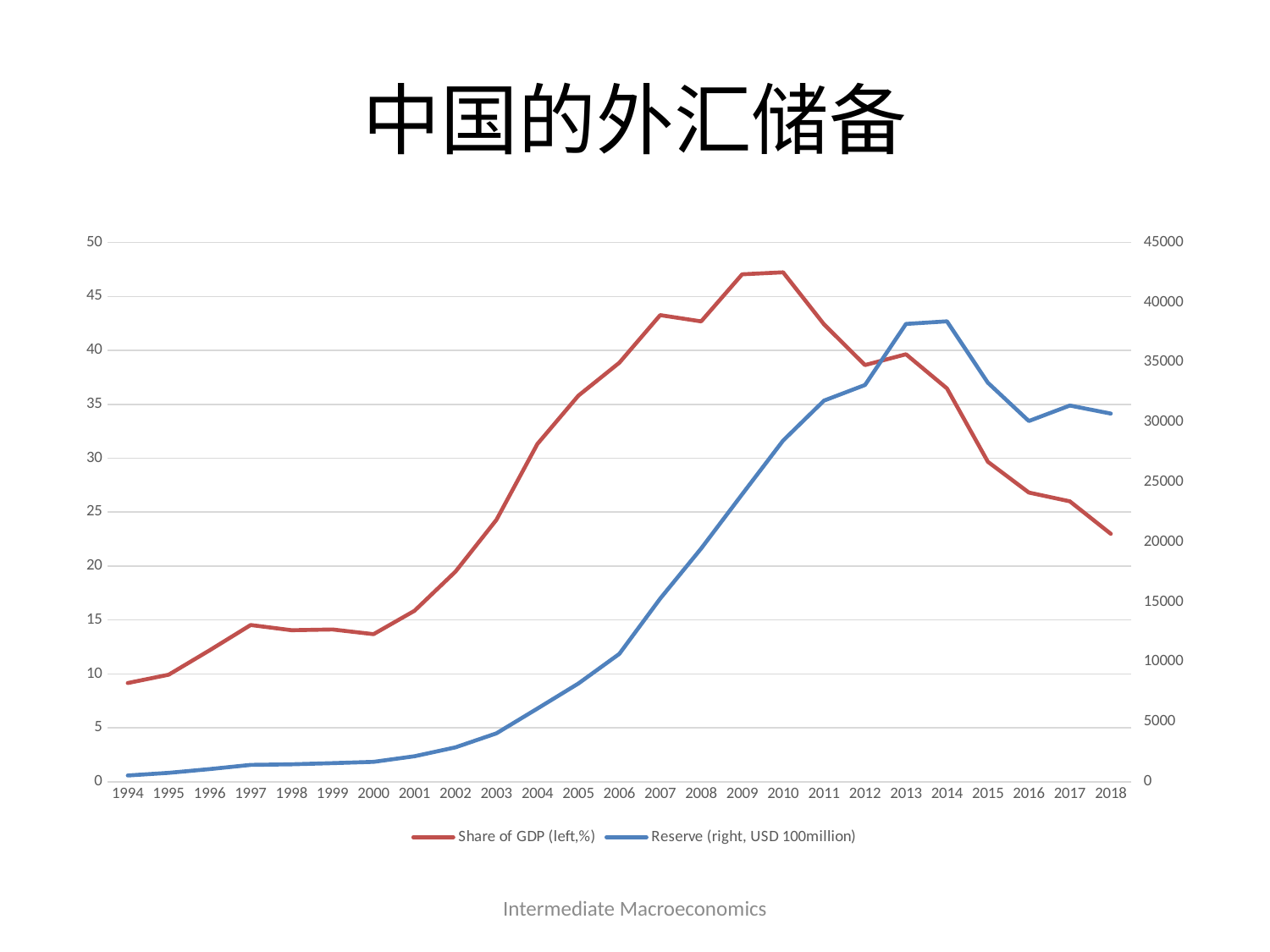
Which year has the lowest value for Share of GDP (left,%)? 1994 Is the Reserve (right, USD 100million) value for 2010 greater or less than 25000? greater Is the Share of GDP (left,%) value for 2018 greater or less than 25? less How many years are plotted along the x axis? 25 Is the Share of GDP (left,%) value for 2006 greater or less than 35? greater How many series does the legend list? 2 Which colour is used for the Reserve (right, USD 100million) series? Blue Which is larger for Share of GDP (left,%): the value for 2007 or the value for 2012? 2007 Does the Share of GDP (left,%) series rise or fall from 2010 to 2018? fall Which year has the lowest value for Reserve (right, USD 100million)? 1994 What kind of chart is shown on the slide? Line chart